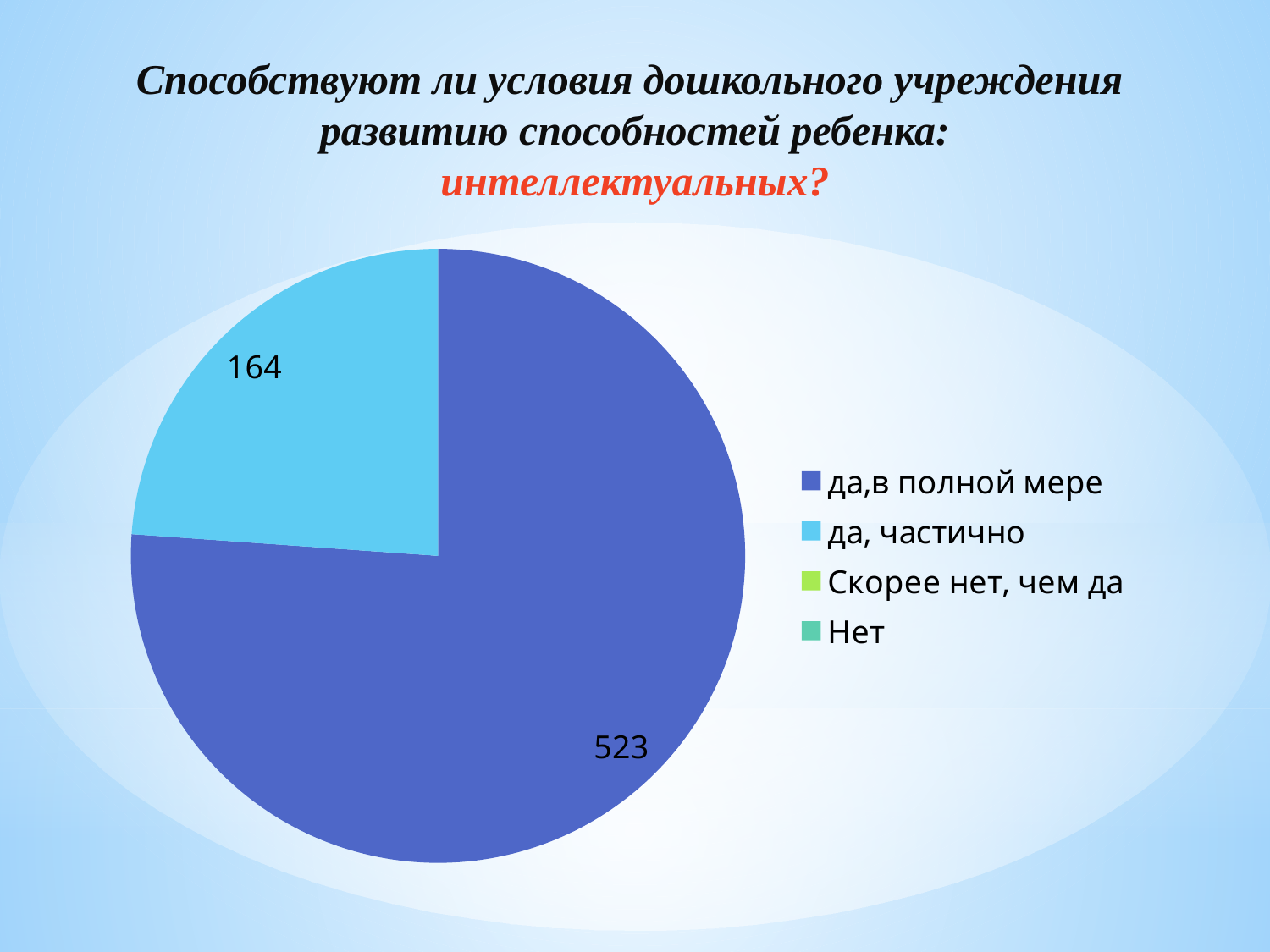
Which word in the chart title is written in red? интеллектуальных? What is the difference between the values for "да,в полной мере" and "да, частично"? 359 What value is shown for the slice "да, частично"? 164 What colour is the legend marker for "да, частично"? light blue What value is shown for the slice "да,в полной мере"? 523 What kind of chart is shown on the slide? pie chart How many categories does the legend list? 4 Which is larger: the value for "да, частично" or the value for "да,в полной мере"? да,в полной мере Which of the two labelled slices is smaller, "да,в полной мере" or "да, частично"? да, частично Which category has the largest slice of the pie? да,в полной мере